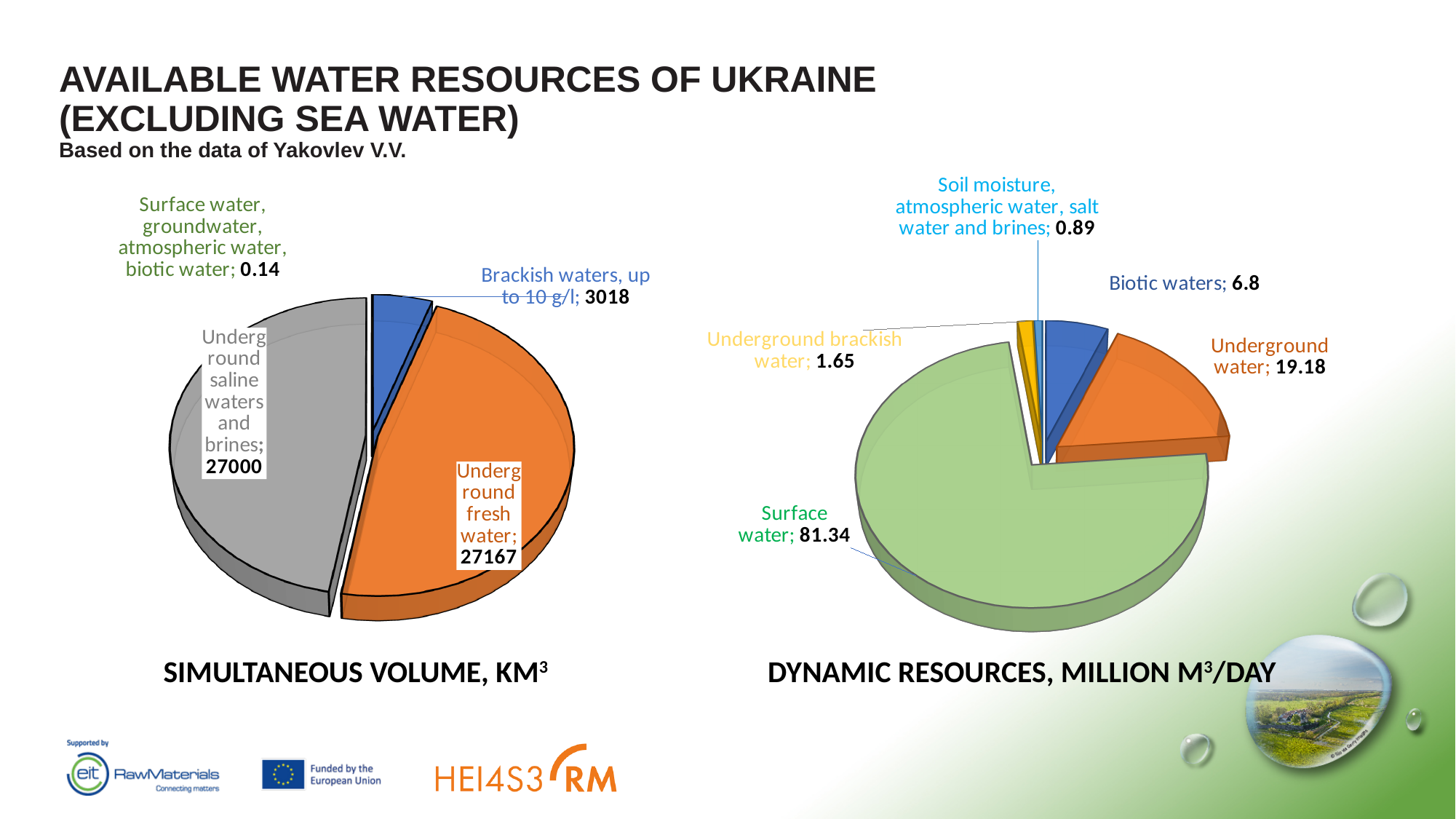
On the Dynamic resources, million m³/day chart, which category has the lowest value? Soil moisture, atmospheric water, salt water and brines On the Simultaneous volume, km³ chart, what is the value for Underground fresh water? 27167 On the Simultaneous volume, km³ chart, what is the value for Brackish waters, up to 10 g/l? 3018 On the Dynamic resources, million m³/day chart, what is the value for Underground water? 19.18 On the Simultaneous volume, km³ chart, what is the difference between Underground fresh water and Underground saline waters and brines? 167 What type of chart is the Simultaneous volume, km³ chart? Pie chart How many slices does the Dynamic resources, million m³/day chart have? 5 On the Simultaneous volume, km³ chart, which category has the lowest value? Surface water, groundwater, atmospheric water, biotic water On the Dynamic resources, million m³/day chart, what is the value for Biotic waters? 6.8 On the Dynamic resources, million m³/day chart, which category has the highest value? Surface water On the Dynamic resources, million m³/day chart, what is the difference between Surface water and Underground water? 62.16 On the Dynamic resources, million m³/day chart, which is larger: Underground brackish water or Biotic waters? Biotic waters